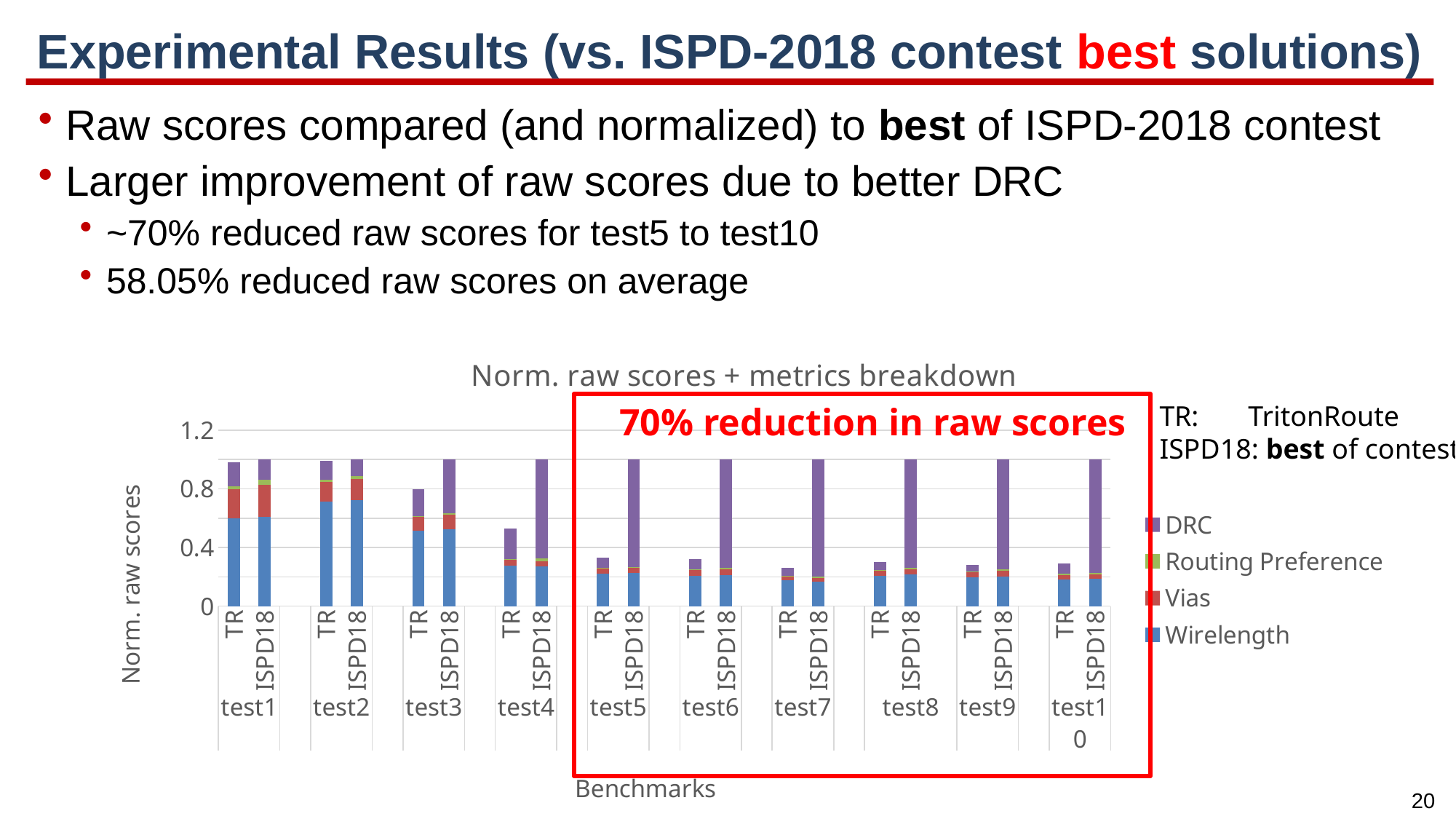
Is the total value of the TR bar for test1 greater or less than 0.8? greater Do the TR bars generally rise or fall from test1 to test10? fall How many series does the chart legend list? 4 How many bars are plotted in the chart in total? 20 What is the title of the chart? Norm. raw scores + metrics breakdown Is the total value of the ISPD18 bar for test7 greater or less than 0.8? greater Which series is shown in purple in the chart legend? DRC How many benchmarks (test groups) are shown along the x axis? 10 Is the total value of the TR bar for test5 greater or less than 0.4? less For test6, which bar is taller, TR or ISPD18? ISPD18 What kind of chart is shown on the slide? stacked bar chart